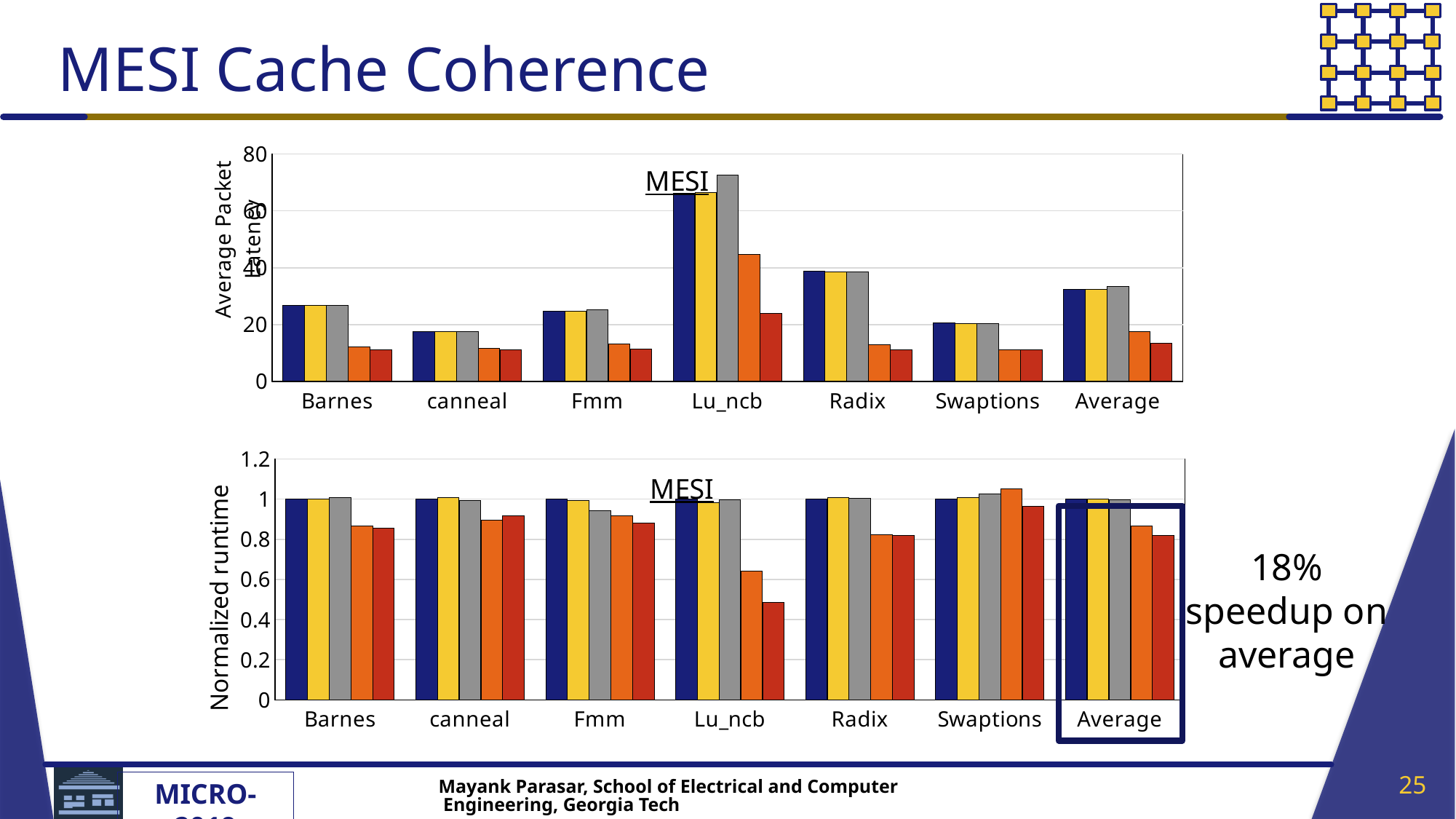
In the bottom chart (Normalized runtime), which is larger: the last (red) bar for Barnes or the last (red) bar for Lu_ncb? Barnes In the top chart (Average Packet Latency), is the tallest bar for Lu_ncb greater or less than 60? greater In the bottom chart (Normalized runtime), is the fourth (orange) bar for Barnes greater or less than 0.8? greater In the top chart (Average Packet Latency), is the first (dark blue) bar for Barnes greater or less than 40? less What is the y-axis label of the bottom chart? Normalized runtime Which category in the bottom chart (Normalized runtime) is highlighted with a box? Average In the bottom chart (Normalized runtime), which category has the lowest bar? Lu_ncb What type of chart is the top chart on the slide? bar chart How many categories are shown on the x axis of the top chart (Average Packet Latency)? 7 In the top chart (Average Packet Latency), which is larger: the first (dark blue) bar for Lu_ncb or the first (dark blue) bar for Radix? Lu_ncb In the top chart (Average Packet Latency), which category has the highest bar? Lu_ncb